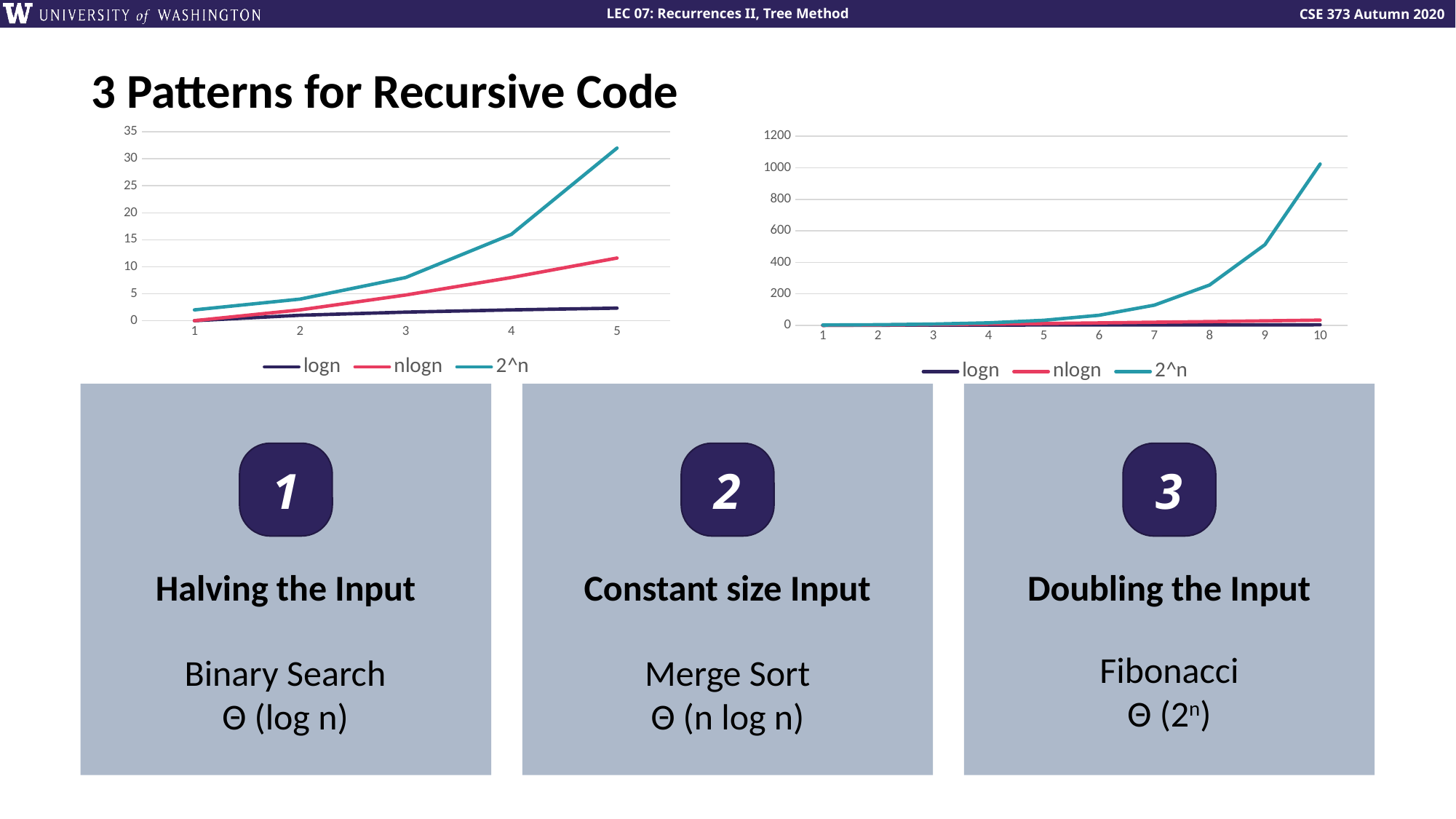
How many x-axis points does the left chart show? 5 Which series are listed in the legend of the right chart? logn, nlogn, 2^n In the left chart, which series has the lowest value at x = 5? logn In the right chart, is the value of 2^n at x = 10 greater or less than 800? greater How many x-axis points does the right chart show? 10 In the left chart, is the value of logn at x = 5 greater or less than 5? less In the left chart, which series has the highest value at x = 5? 2^n How many series does the legend of the left chart list? 3 In the right chart, does the 2^n series rise or fall as x increases from 1 to 10? rise What type of chart is the chart on the left of the slide? line chart In the left chart, is the value of 2^n at x = 5 greater or less than 30? greater